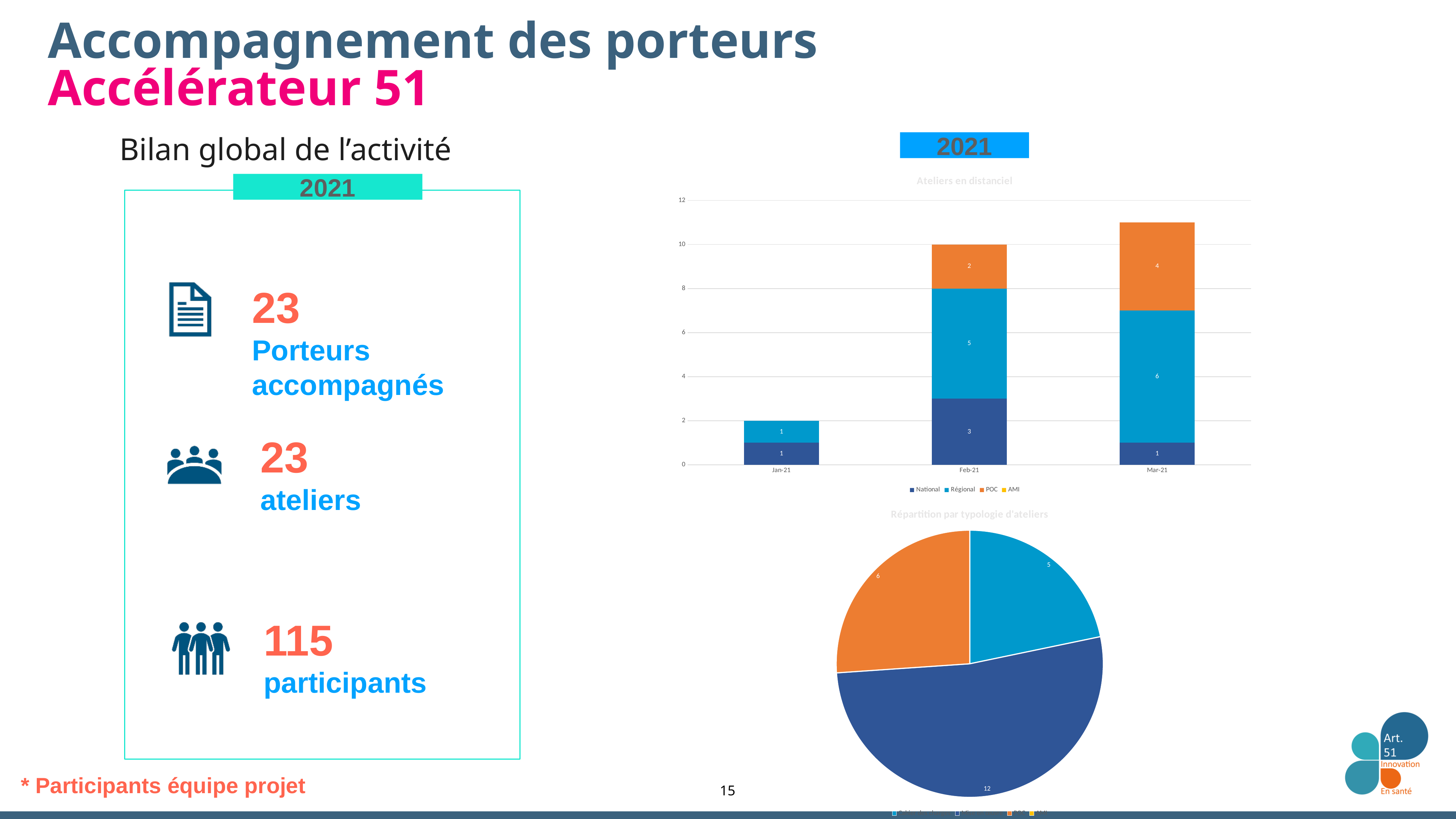
In the 'Ateliers en distanciel' chart, what is the value for Régional in Feb-21? 5 How many months are shown on the x axis of the 'Ateliers en distanciel' chart? 3 In the 'Ateliers en distanciel' chart, is the National value larger in Feb-21 or in Mar-21? Feb-21 How many series does the legend of the 'Ateliers en distanciel' chart list? 4 In the 'Ateliers en distanciel' chart, what is the total of the stacked bar for Feb-21? 10 In the 'Ateliers en distanciel' chart, what is the difference between the Régional value in Mar-21 and in Feb-21? 1 In the 'Ateliers en distanciel' chart, what is the total of the stacked bar for Mar-21? 11 In the 'Ateliers en distanciel' chart, what is the value for POC in Mar-21? 4 Do the bar totals in the 'Ateliers en distanciel' chart rise or fall from Jan-21 to Mar-21? Rise What kind of chart is the 'Ateliers en distanciel' chart? Stacked bar chart In the 'Ateliers en distanciel' chart, which month has the lowest total? Jan-21 In the 'Répartition par typologie d'ateliers' pie chart, what is the value of the largest slice? 12